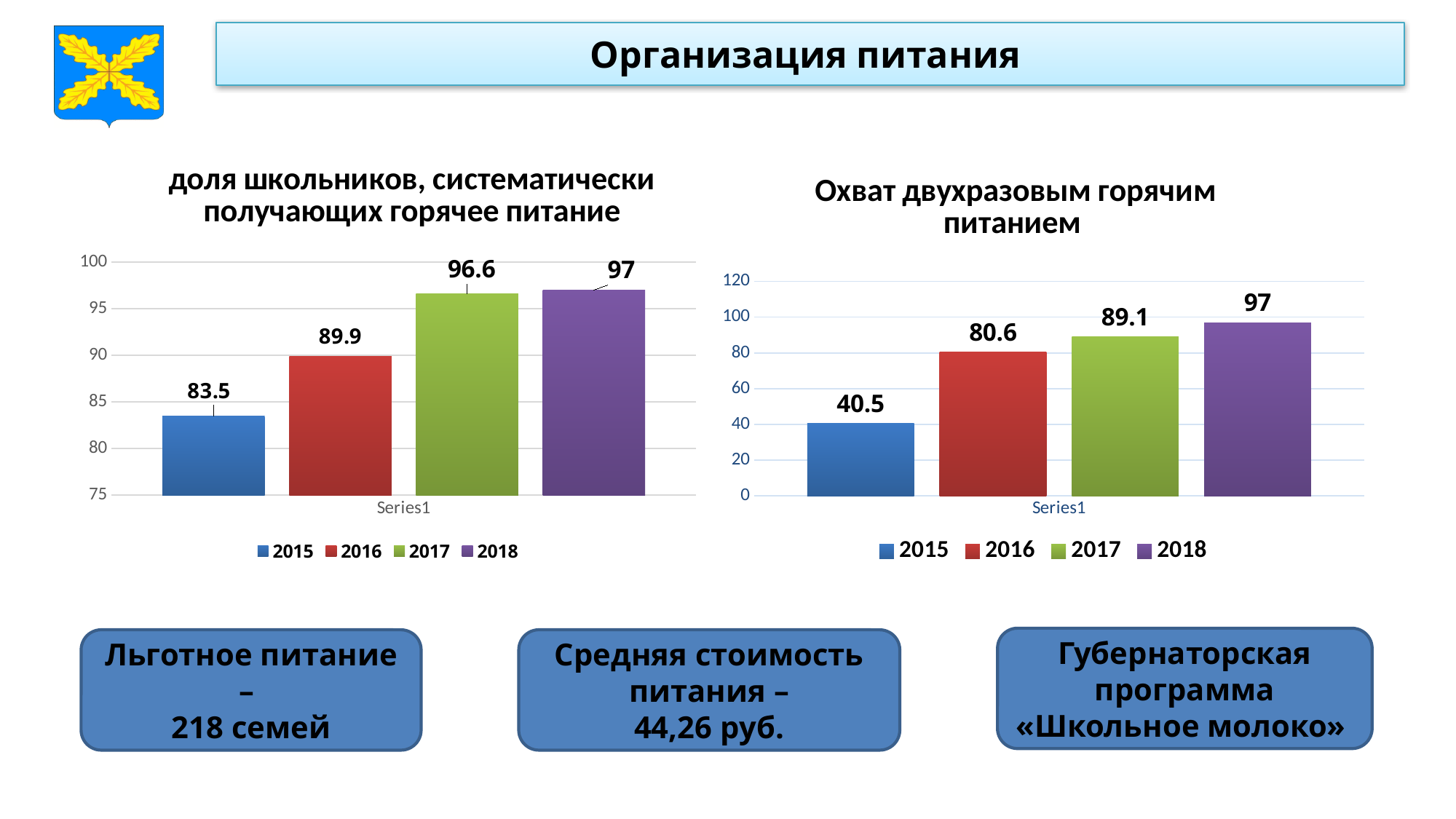
How many series does the legend of the left chart 'доля школьников, систематически получающих горячее питание' list? 4 In the right chart 'Охват двухразовым горячим питанием', what is the difference between the 2016 and 2015 values? 40.1 In the right chart 'Охват двухразовым горячим питанием', which year has the lowest value? 2015 In the right chart 'Охват двухразовым горячим питанием', do the values rise or fall from 2015 to 2018? rise In the left chart 'доля школьников, систематически получающих горячее питание', what is the difference between the 2016 and 2015 values? 6.4 What kind of chart is the right chart 'Охват двухразовым горячим питанием'? bar chart In the right chart 'Охват двухразовым горячим питанием', what is the value for 2016? 80.6 In the left chart 'доля школьников, систематически получающих горячее питание', what is the value for 2017? 96.6 In the left chart 'доля школьников, систематически получающих горячее питание', what is the value for 2015? 83.5 In the left chart 'доля школьников, систематически получающих горячее питание', which year has the highest value? 2018 In the right chart 'Охват двухразовым горячим питанием', which is larger, the value for 2017 or the value for 2016? 2017 In the right chart 'Охват двухразовым горячим питанием', what is the value for 2018? 97